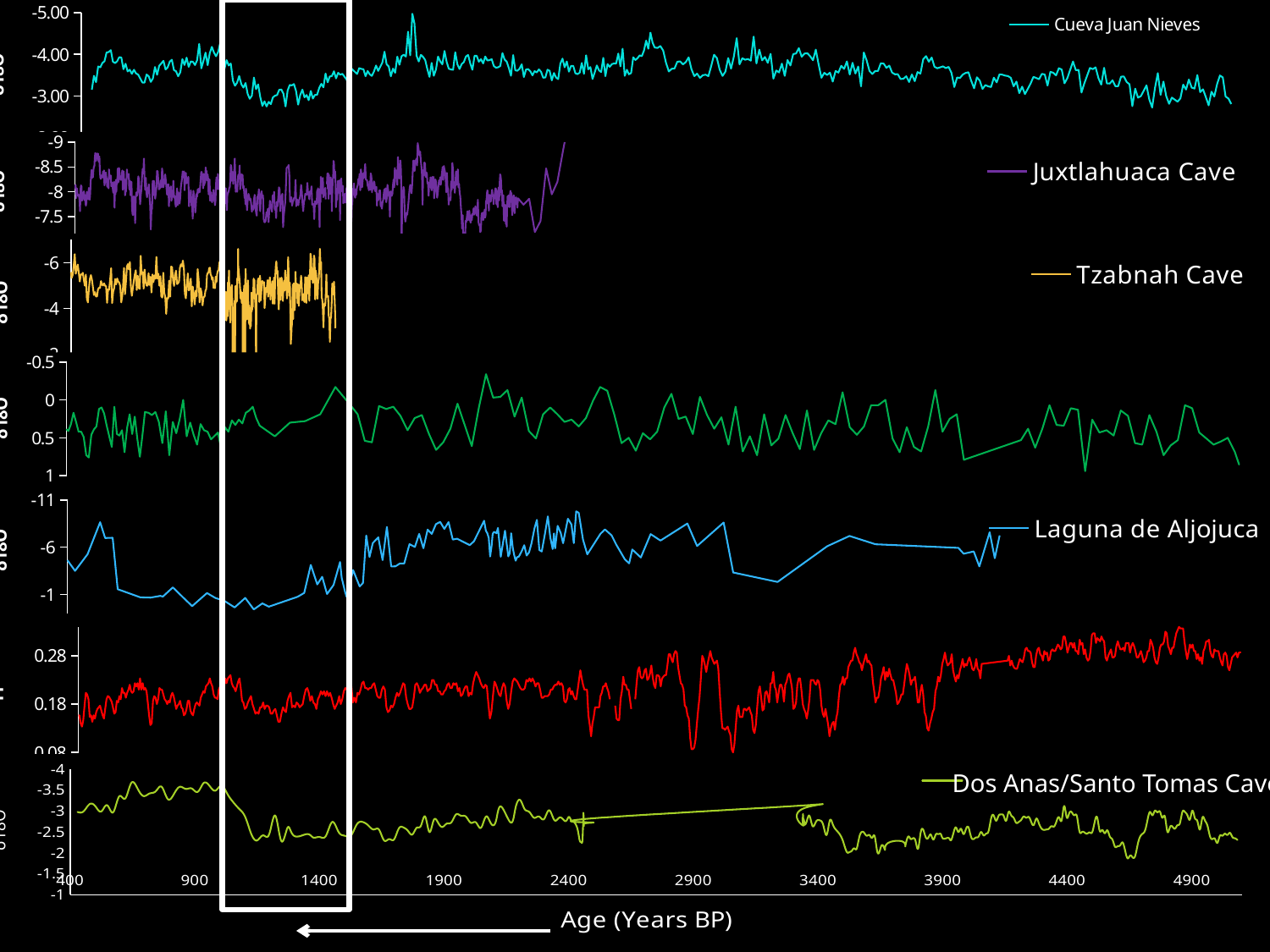
How many tick labels are shown on the x axis? 10 How many series are labelled by name on the chart? 5 Along the x axis from 400 to 4900 years BP, does the red series generally rise or fall? rise What is the title of the x axis? Age (Years BP) Does the Juxtlahuaca Cave series extend beyond 2900 years BP on the x axis? No What kind of chart is shown on the slide? line chart Which named series is plotted in the bottom panel of the chart? Dos Anas/Santo Tomas Cave What is the largest age value labelled on the x axis? 4900 Is the Laguna de Aljojuca value at about 1000 years BP greater or less than -6? greater Which series is plotted in cyan at the top of the slide? Cueva Juan Nieves What is the smallest age value labelled on the x axis? 400